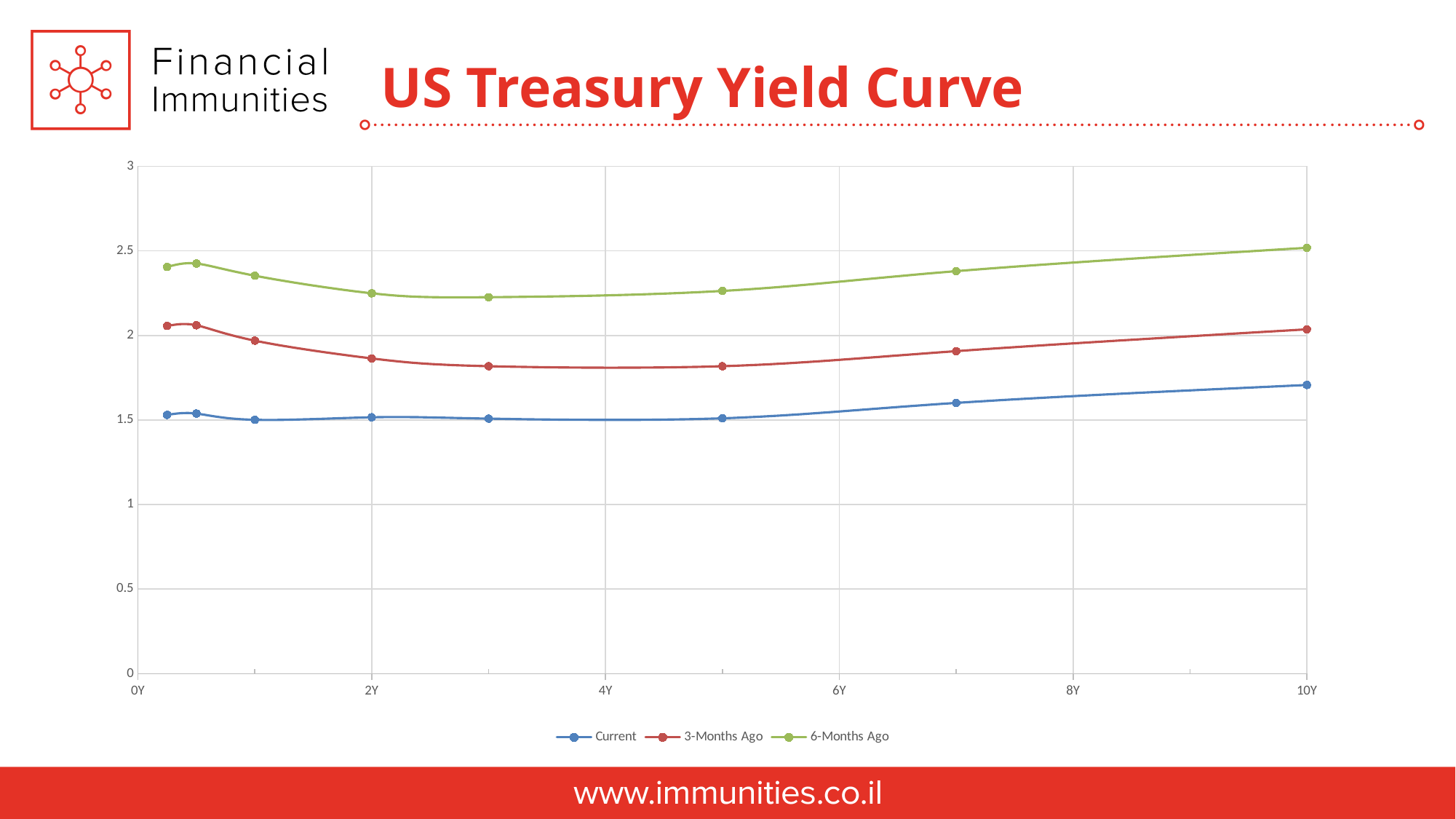
Is the value for the 6-Months Ago series at 2Y greater or less than 2.5? less What kind of chart is shown on the slide? line chart Which colour is used for the 3-Months Ago series? red Which series has the highest value at 10Y? 6-Months Ago What is the title of the chart? US Treasury Yield Curve Is the value for the Current series at 10Y greater or less than 1.5? greater How many series does the legend list? 3 Does the Current series rise or fall between 5Y and 10Y? rise Is the value for the 3-Months Ago series at 3Y greater or less than 2? less At which maturity does the 6-Months Ago series reach its highest value? 10Y Which series has the lowest values across the whole curve? Current How many data points are plotted for the Current series? 8